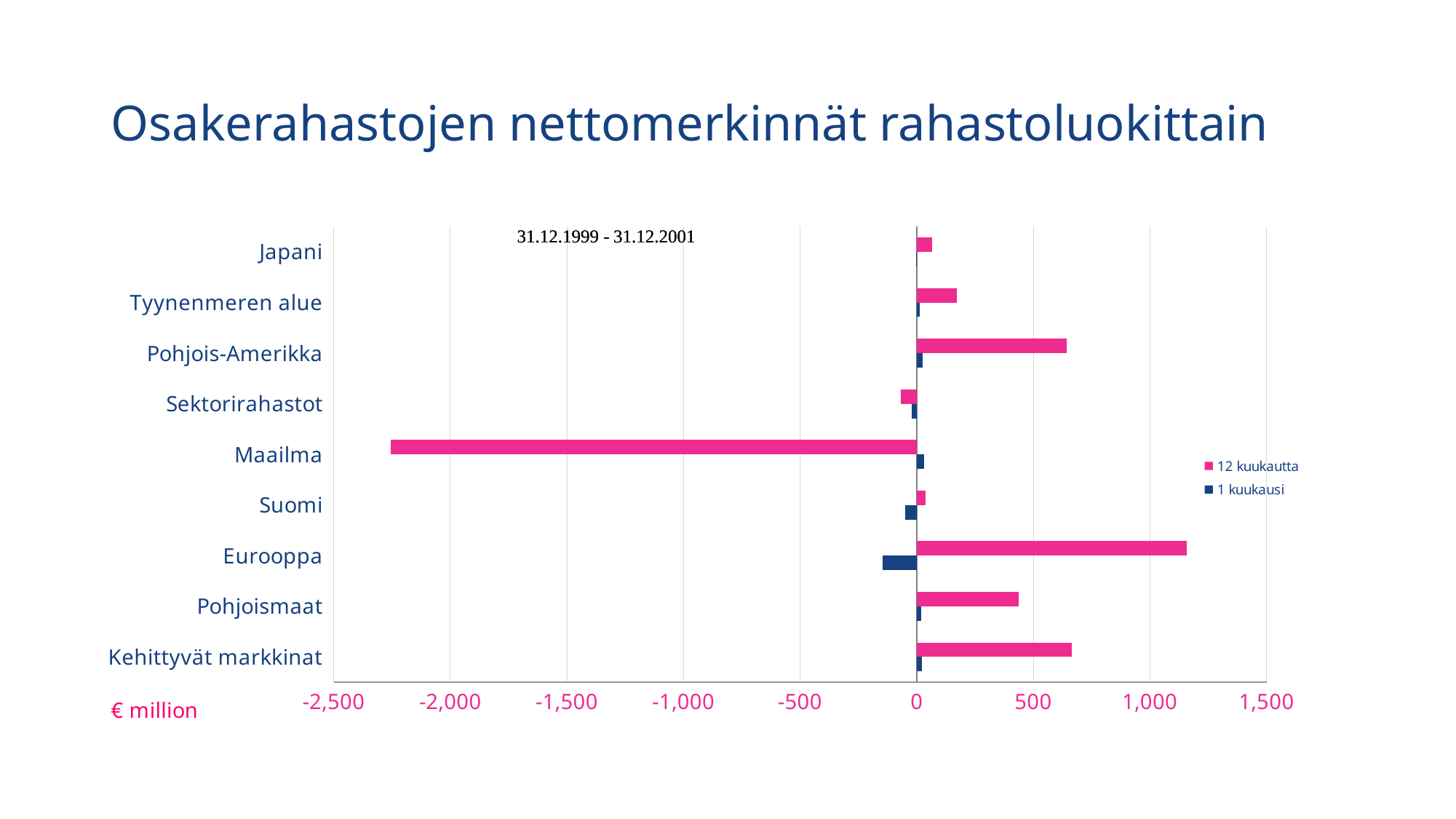
Is the 12 kuukautta value for Pohjoismaat greater or less than 500? less Is the 12 kuukautta value for Maailma greater or less than -2,000? less Which is larger for the 12 kuukautta series: Eurooppa or Pohjois-Amerikka? Eurooppa How many series does the chart legend list? 2 Which category has the lowest value for the 12 kuukautta series? Maailma Which category has the lowest value for the 1 kuukausi series? Eurooppa What is the title of the chart on the slide? Osakerahastojen nettomerkinnät rahastoluokittain What kind of chart is shown on the slide? Bar chart Is the 12 kuukautta value for Eurooppa greater or less than 1,000? greater How many fund categories are listed on the vertical axis of the chart? 9 Which category has the highest value for the 12 kuukautta series? Eurooppa Which is larger for the 12 kuukautta series: Kehittyvät markkinat or Pohjoismaat? Kehittyvät markkinat